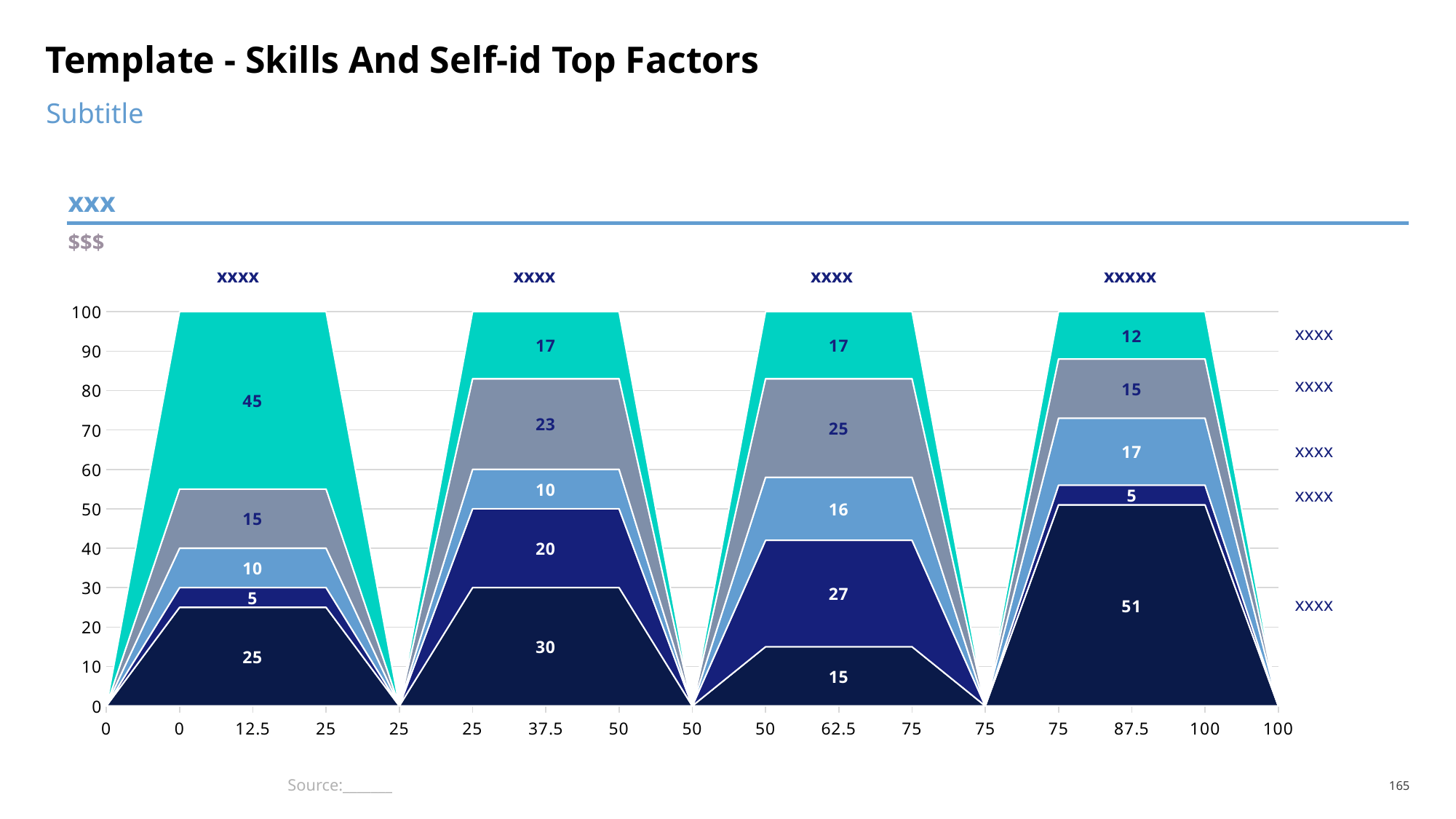
How many series are stacked in each group? 5 What is the total of the stacked segments in the second group from the left? 100 What is the value of the grey segment in the third group from the left? 25 Is the teal segment larger in the first group or in the fourth group? First group What is the value of the bottom (darkest navy) segment in the fourth group from the left? 51 What is the value of the top (teal) segment in the first group from the left? 45 What kind of chart is shown on the slide? Stacked area chart What is the difference between the bottom (darkest navy) segment values of the fourth group and the first group? 26 How many groups (categories) are plotted along the x axis? 4 What is the value of the bottom (darkest navy) segment in the first group from the left? 25 What is the value of the light blue segment in the second group from the left? 10 Which segment has the largest value in the first group from the left? The top (teal) segment, 45